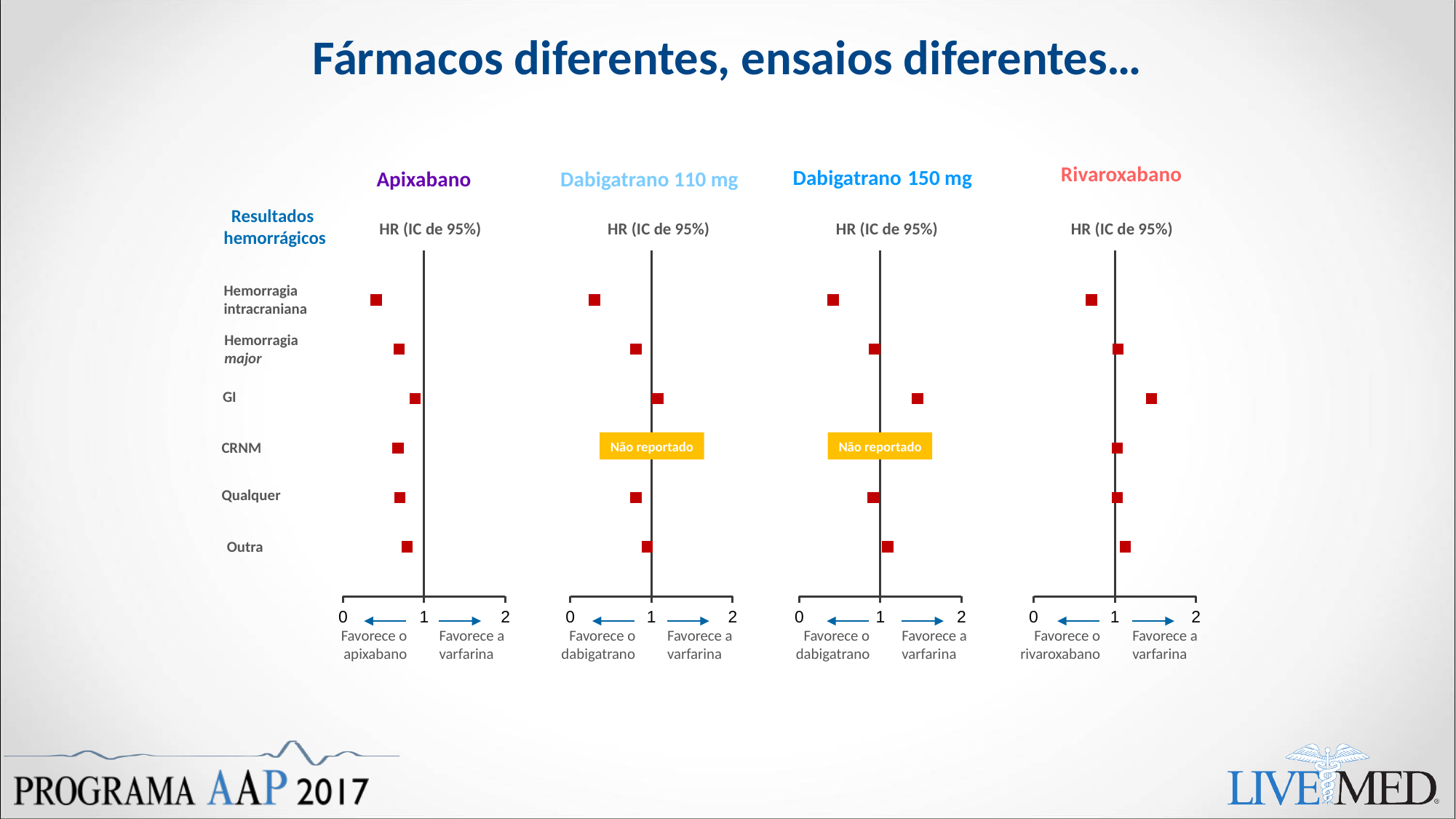
In the Dabigatrano 110 mg chart, is the HR for Hemorragia intracraniana greater or less than 1? less In the Apixabano chart, is the HR for Hemorragia intracraniana greater or less than 1? less In the Rivaroxabano chart, is the HR for GI greater or less than 1? greater In the Dabigatrano 150 mg chart, which outcome has the highest HR? GI Which outcome is marked 'Não reportado' in the Dabigatrano 110 mg and Dabigatrano 150 mg charts? CRNM How many drug charts are shown on the slide? 4 How many bleeding outcome categories are listed down the left side of the charts? 6 What is the maximum value shown on the x axis of each chart? 2